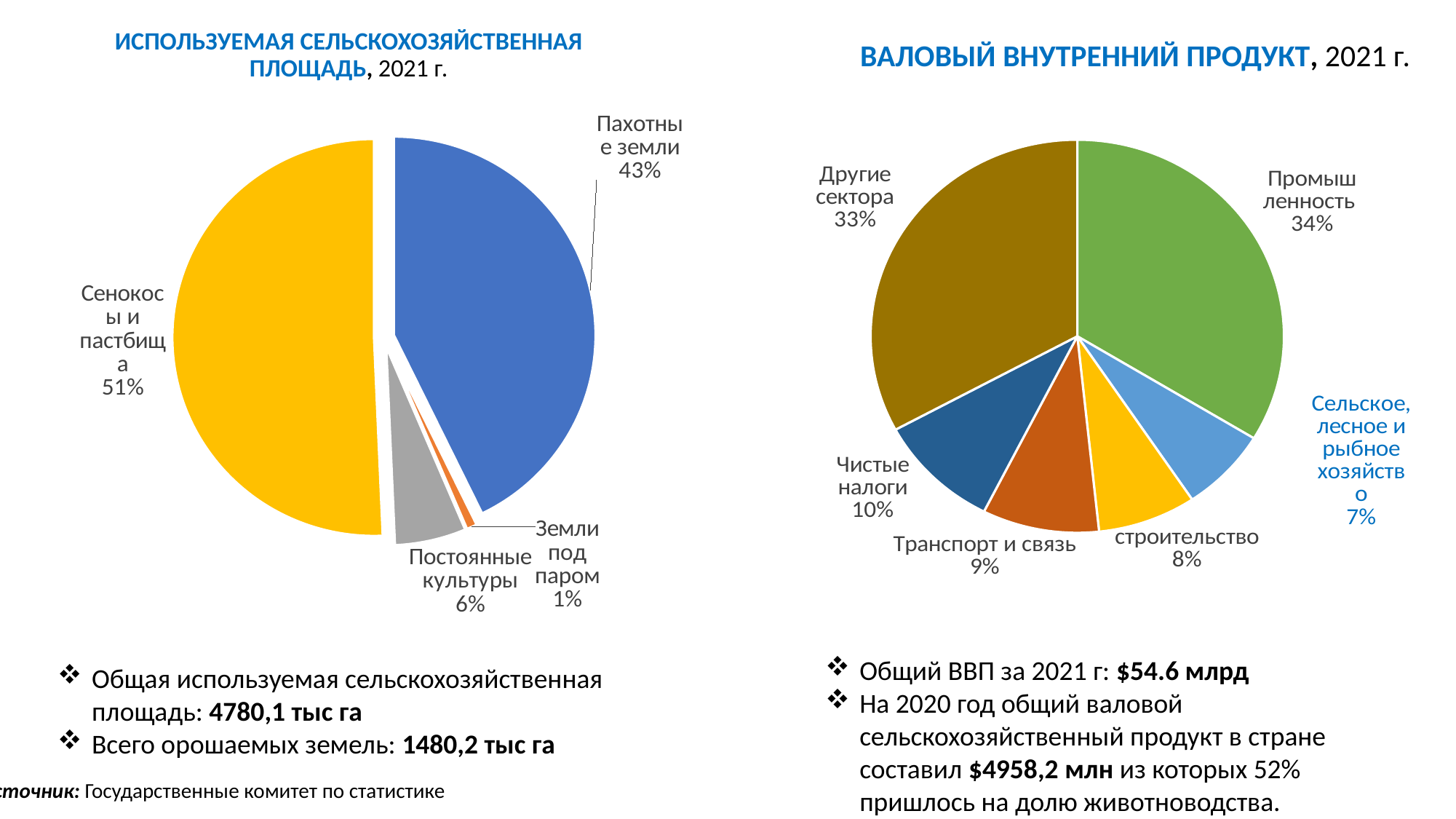
In the left pie chart (agricultural area, 2021), what is the difference in percentage points between Сенокосы и пастбища and Постоянные культуры? 45 percentage points In the left pie chart (agricultural area, 2021), what share is labelled for Пахотные земли? 43% In the right pie chart (GDP, 2021), how many sectors are shown? 6 In the left pie chart (agricultural area, 2021), how many slices are there? 4 In the right pie chart (GDP, 2021), what is the difference in percentage points between Другие сектора and Транспорт и связь? 24 percentage points In the left pie chart (agricultural area, 2021), which category has the smallest share? Земли под паром In the left pie chart (agricultural area, 2021), what share is labelled for Сенокосы и пастбища? 51% In the right pie chart (GDP, 2021), what share is labelled for Промышленность? 34% What type of chart is used on the left side of the slide for the agricultural area? Pie chart In the right pie chart (GDP, 2021), which category has the largest share? Промышленность In the right pie chart (GDP, 2021), which is larger: Чистые налоги or строительство? Чистые налоги